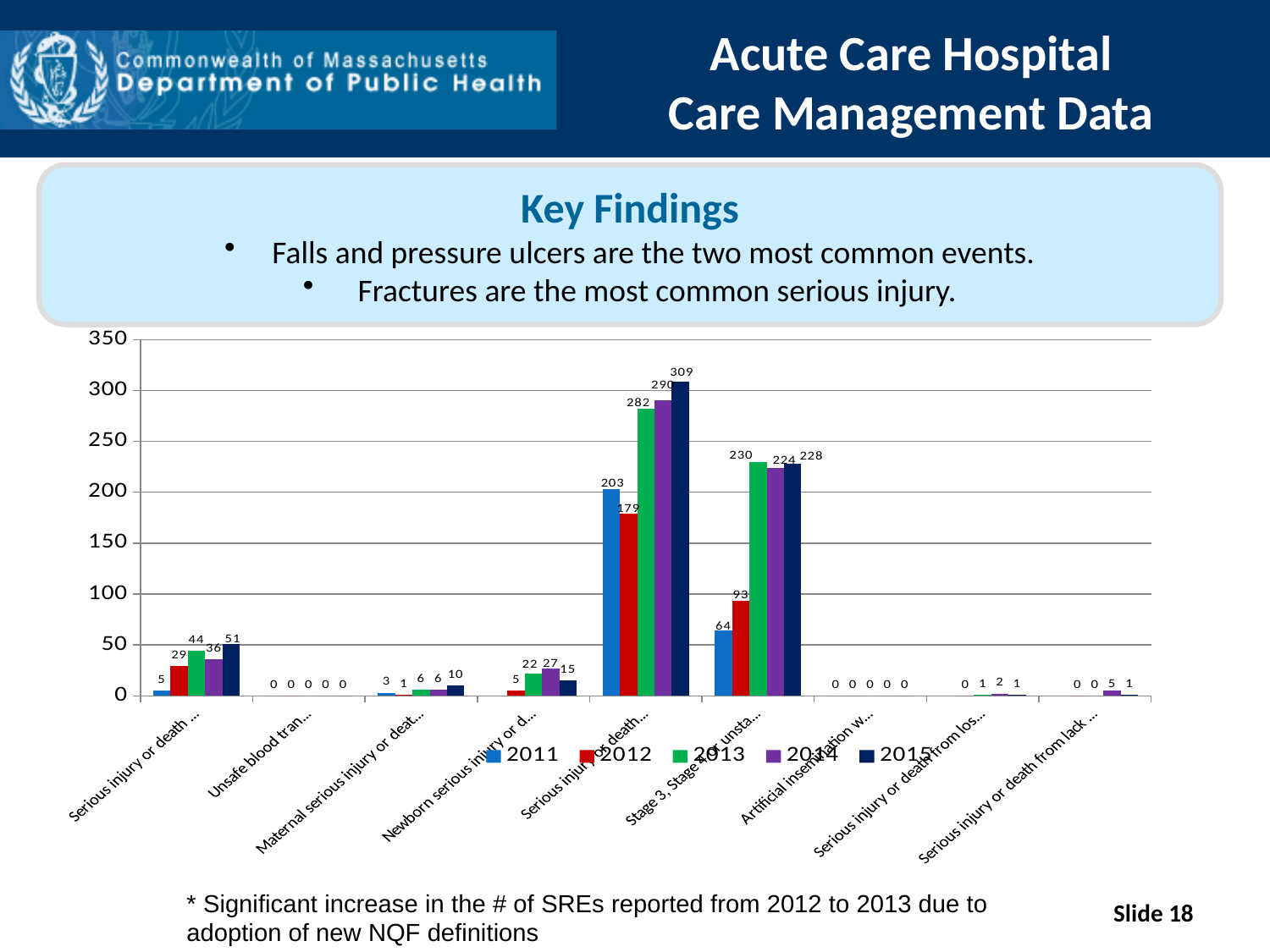
What is the highest value shown anywhere on the chart? 309 What is the difference between the 2015 and 2011 values for the 'Stage 3, Stage 4, unsta...' category? 164 What is the 2013 value for the 'Stage 3, Stage 4, unsta...' category? 230 What kind of chart is shown on the slide? bar chart How many categories are shown along the x axis? 9 What is the 2015 value for the 'Stage 3, Stage 4, unsta...' category? 228 For the fifth category from the left, what is the difference between the 2015 value and the 2011 value? 106 How many series does the legend list? 5 What is the 2015 value for the 'Maternal serious injury or deat...' category? 10 What is the 2012 value for the first category on the left ('Serious injury or death ...')? 29 Is the 2012 value for the 'Stage 3, Stage 4, unsta...' category greater or less than 100? less For the 'Stage 3, Stage 4, unsta...' category, which year has the larger value, 2013 or 2014? 2013